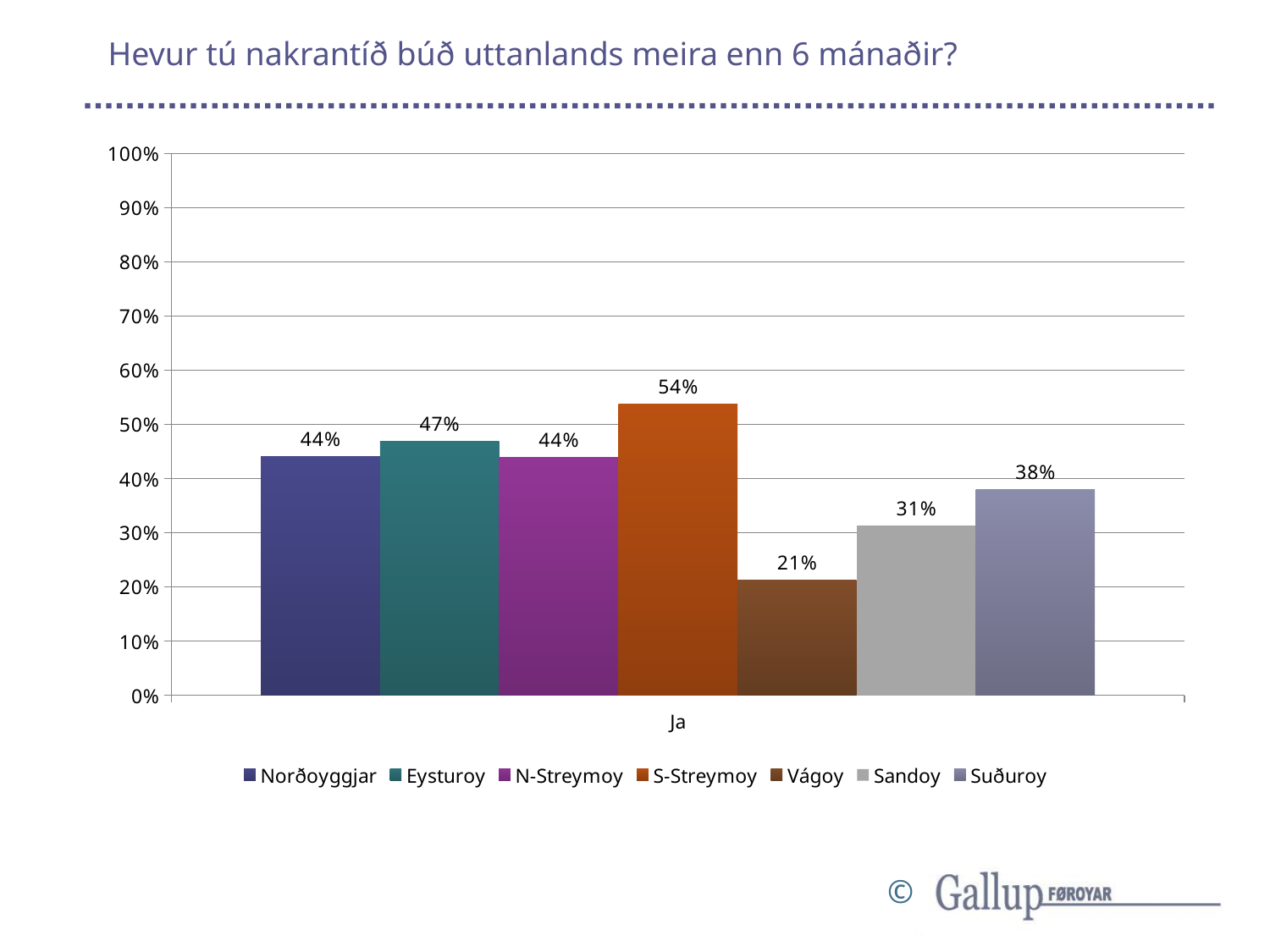
What is the value for S-Streymoy? 54% Which is larger, the value for Sandoy or the value for Suðuroy? Suðuroy What is the difference between the values for Eysturoy and Norðoyggjar? 3% What is the difference between the values for S-Streymoy and Vágoy? 33% How many series does the legend list? 7 Which region has the highest value? S-Streymoy What is the label on the x axis category? Ja Is the value for Eysturoy greater or less than 40%? greater What is the value for Vágoy? 21% What is the value for Suðuroy? 38% What kind of chart is shown on the slide? bar chart Which region has the lowest value? Vágoy